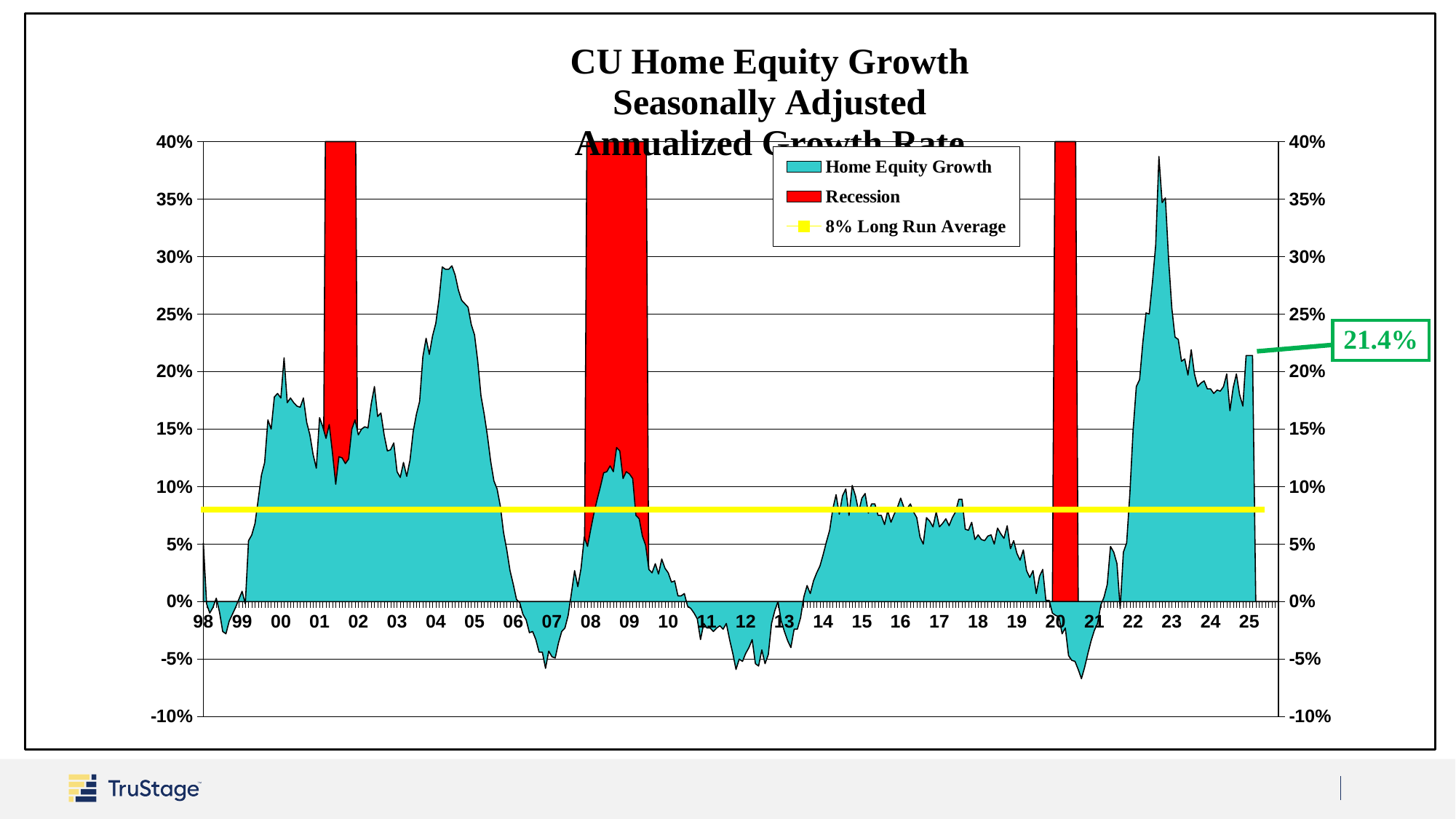
Is the Home Equity Growth value around 2012 greater or less than 0%? less What is the title of the chart? CU Home Equity Growth Seasonally Adjusted Annualized Growth Rate Is the labeled 2025 value of 21.4% greater or less than the 8% long run average? greater How many recession periods are shaded on the chart? 3 Is the peak Home Equity Growth value around 2004-05 greater or less than 25%? greater Is the peak Home Equity Growth value around 2022-23 greater or less than 35%? greater In which year does Home Equity Growth reach its highest point on the chart? 2022 Which peak is higher: the one around 2004-05 or the one around 2022-23? 2022-23 What is the long run average shown by the yellow line? 8% How many series does the legend list? 3 What is the most recent value labeled on the chart for Home Equity Growth? 21.4% What kind of chart is used to show Home Equity Growth? Area chart